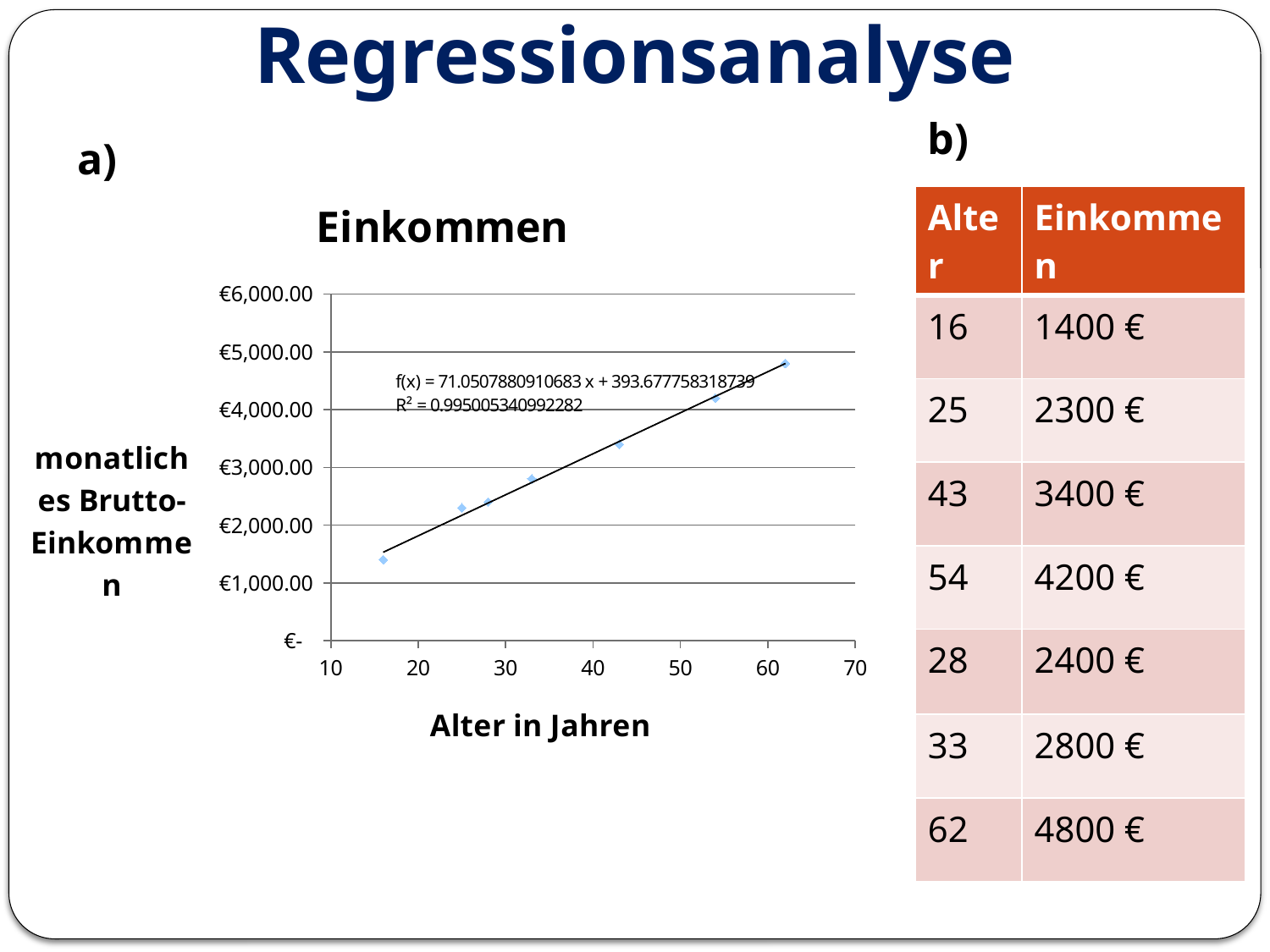
How many data points are plotted in the Einkommen chart? 7 What is the title of the chart? Einkommen Which has the larger plotted income value, the point at age 54 or the point at age 33? age 54 Is the plotted income value at age 62 greater or less than €4,000.00? greater What R² value is printed on the chart? R² = 0.995005340992282 Is the plotted income value at age 43 greater or less than €3,000.00? greater Is the plotted income value at age 25 greater or less than €3,000.00? less At which age on the x axis is the plotted income lowest? 16 At which age on the x axis is the plotted income highest? 62 What kind of chart is shown on the slide? scatter chart Do the plotted values in the Einkommen chart rise or fall as age increases along the x axis? rise